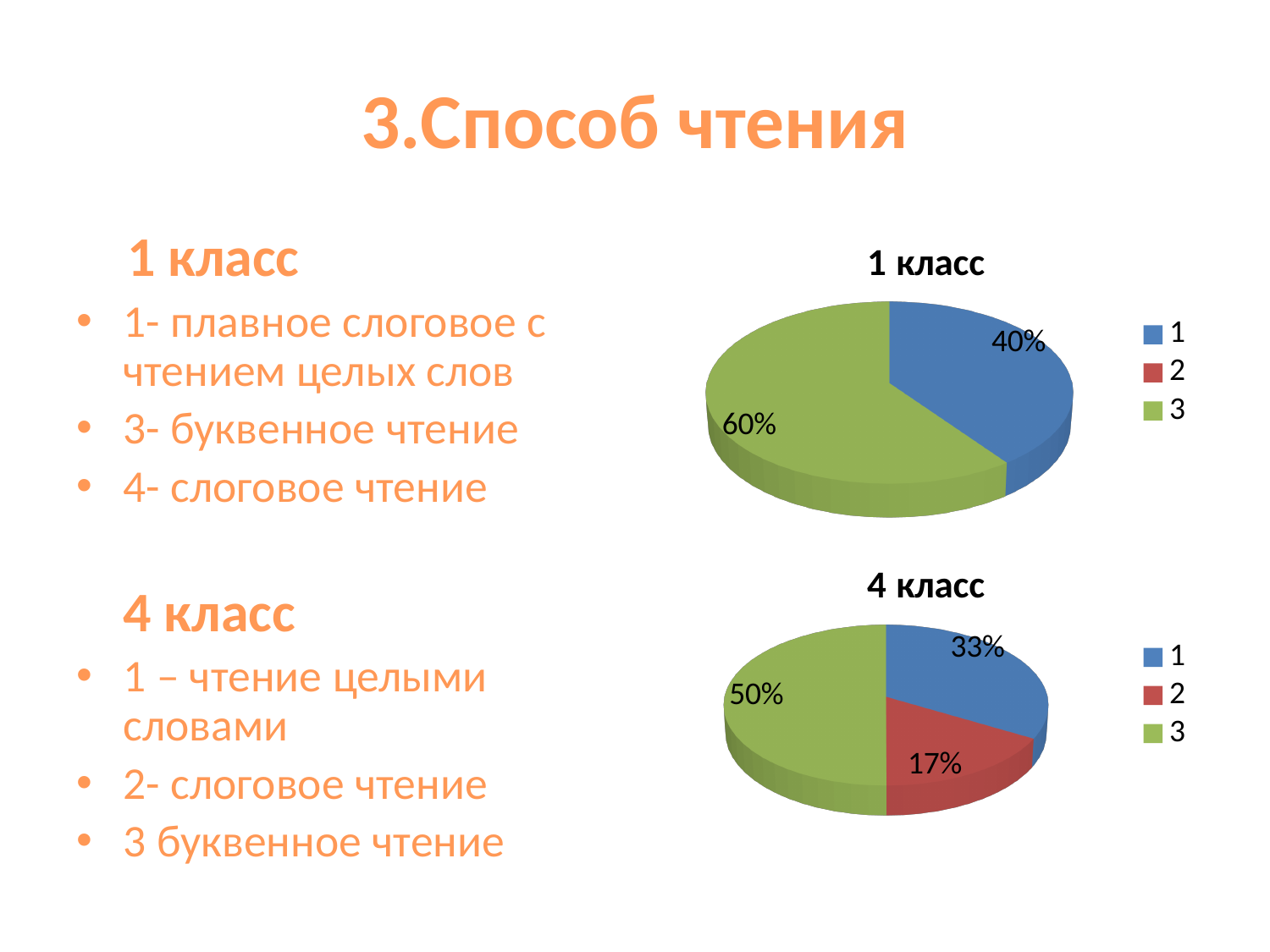
In the "4 класс" chart, which category has the smallest slice? 2 In the "4 класс" chart, what share does category 2 have? 17% What colour is category 3 in the "4 класс" chart? green In the "4 класс" chart, what share does category 3 have? 50% What kind of chart is the "1 класс" chart? pie chart How many entries does the legend of the "1 класс" chart list? 3 In the "1 класс" chart, what share does category 1 have? 40% In the "4 класс" chart, what is the difference between the shares of category 3 and category 1? 17% In the "1 класс" chart, what is the difference between the shares of category 3 and category 1? 20% In the "4 класс" chart, which is larger: the share of category 1 or category 2? category 1 In the "1 класс" chart, what share does category 3 have? 60% In the "1 класс" chart, which category has the largest slice? 3